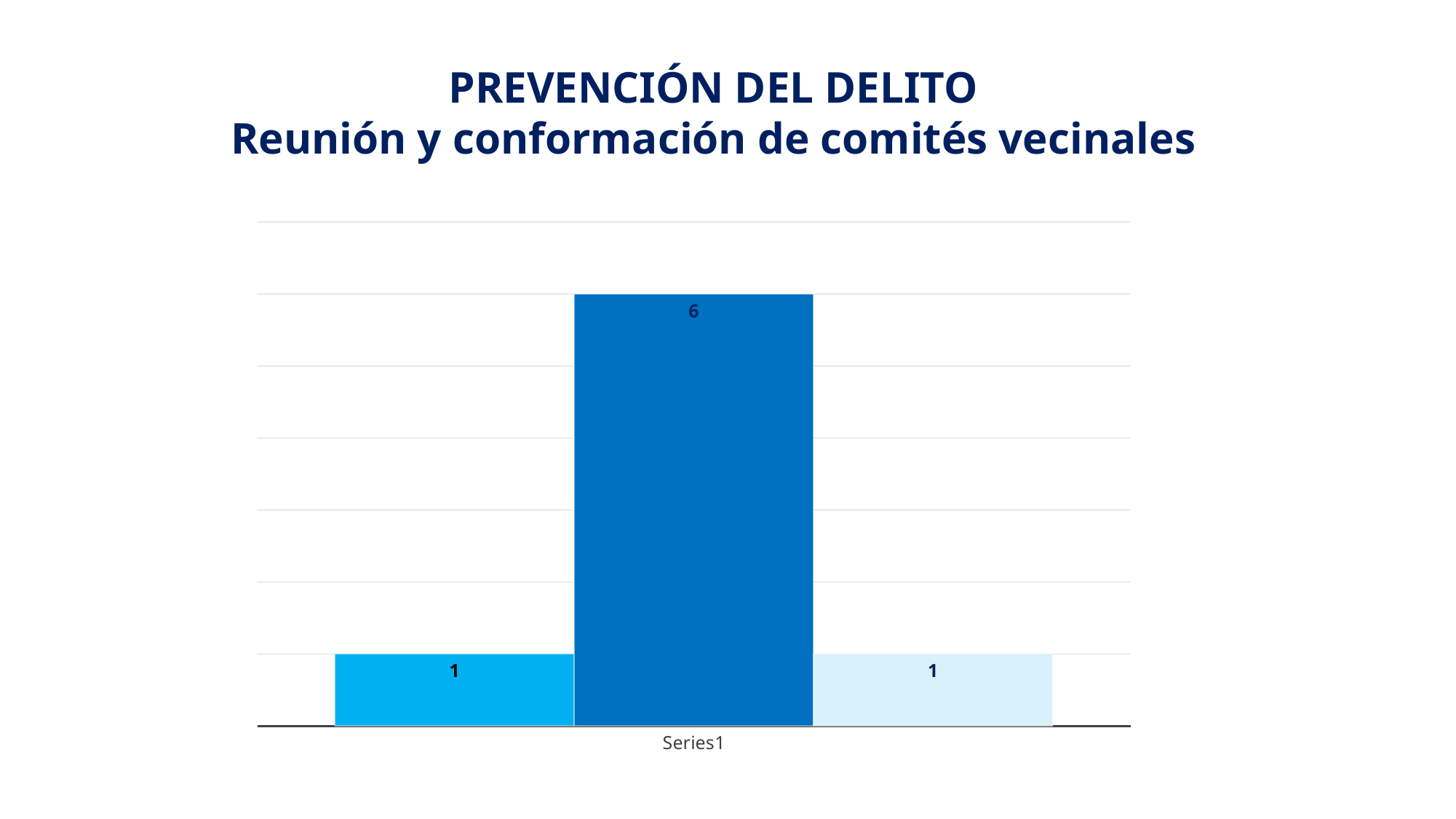
What is the value of the rightmost bar in the chart? 1 What is the category label shown on the x axis? Series1 What is the value of the leftmost bar in the chart? 1 What is the value of the tallest bar in the chart? 6 Which bar is larger, the middle bar or the rightmost bar? the middle bar What is the value of the dark blue middle bar? 6 What is the difference between the middle bar and the leftmost bar? 5 How many bars are plotted in the chart? 3 What is the title of the slide above the chart? PREVENCIÓN DEL DELITO Reunión y conformación de comités vecinales What is the total of the three bar values shown in the chart? 8 What type of chart is shown on the slide? bar chart